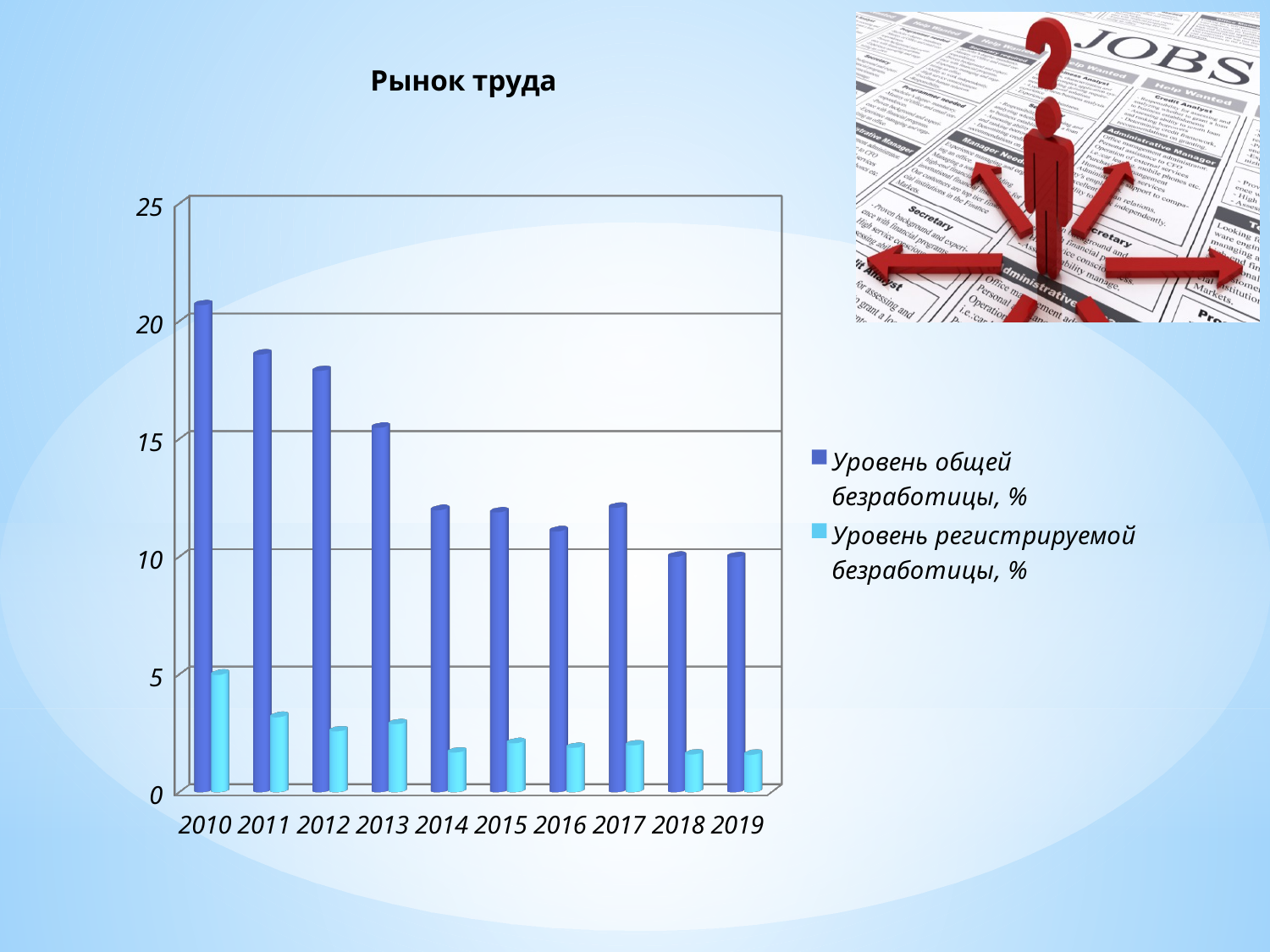
Which is larger, Уровень общей безработицы, % in 2012 or in 2016? 2012 Is the value for Уровень регистрируемой безработицы, % in 2019 greater or less than 5? less Which year has the highest value for Уровень общей безработицы, %? 2010 What is the title of the chart? Рынок труда Is the value for Уровень общей безработицы, % in 2010 greater or less than 20? greater Does Уровень общей безработицы, % generally rise or fall from 2010 to 2019? fall Which year has the highest value for Уровень регистрируемой безработицы, %? 2010 What kind of chart is shown on the slide? bar chart How many years are shown on the x axis of the chart? 10 Is the value for Уровень общей безработицы, % in 2011 greater or less than 20? less How many series does the legend list? 2